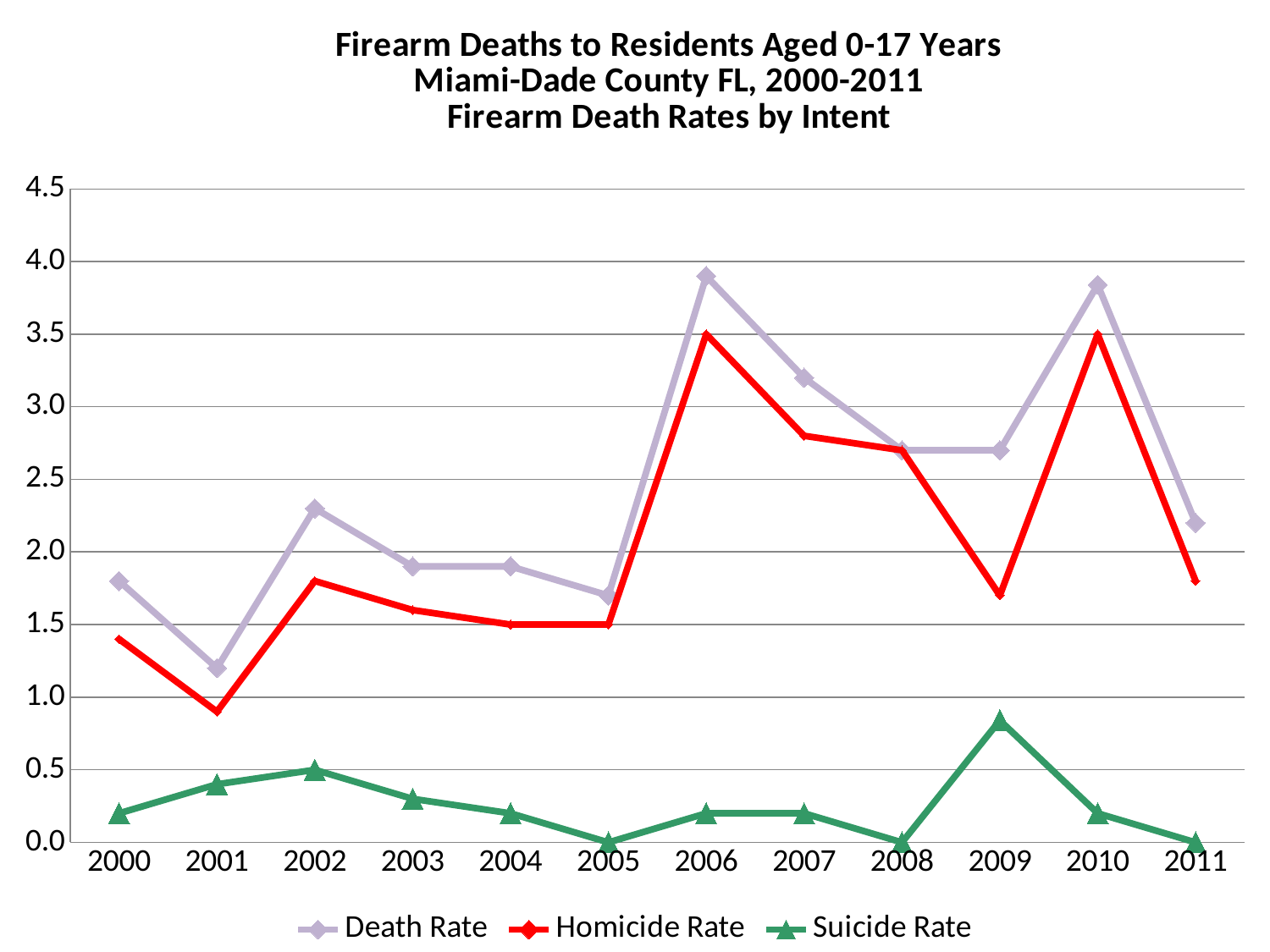
In which year is the Death Rate lowest? 2001 How many series does the legend list? 3 What is the Suicide Rate in 2005? 0.0 What kind of chart is shown on the slide? line chart Which is larger in 2006, the Death Rate or the Homicide Rate? Death Rate What is the Suicide Rate in 2002? 0.5 In which year is the Suicide Rate highest? 2009 Does the Suicide Rate rise or fall from 2002 to 2005? fall What is the Homicide Rate in 2006? 3.5 Is the Homicide Rate in 2009 greater or less than 2.0? less How many years are plotted along the x axis? 12 Is the Death Rate in 2006 greater or less than 3.5? greater